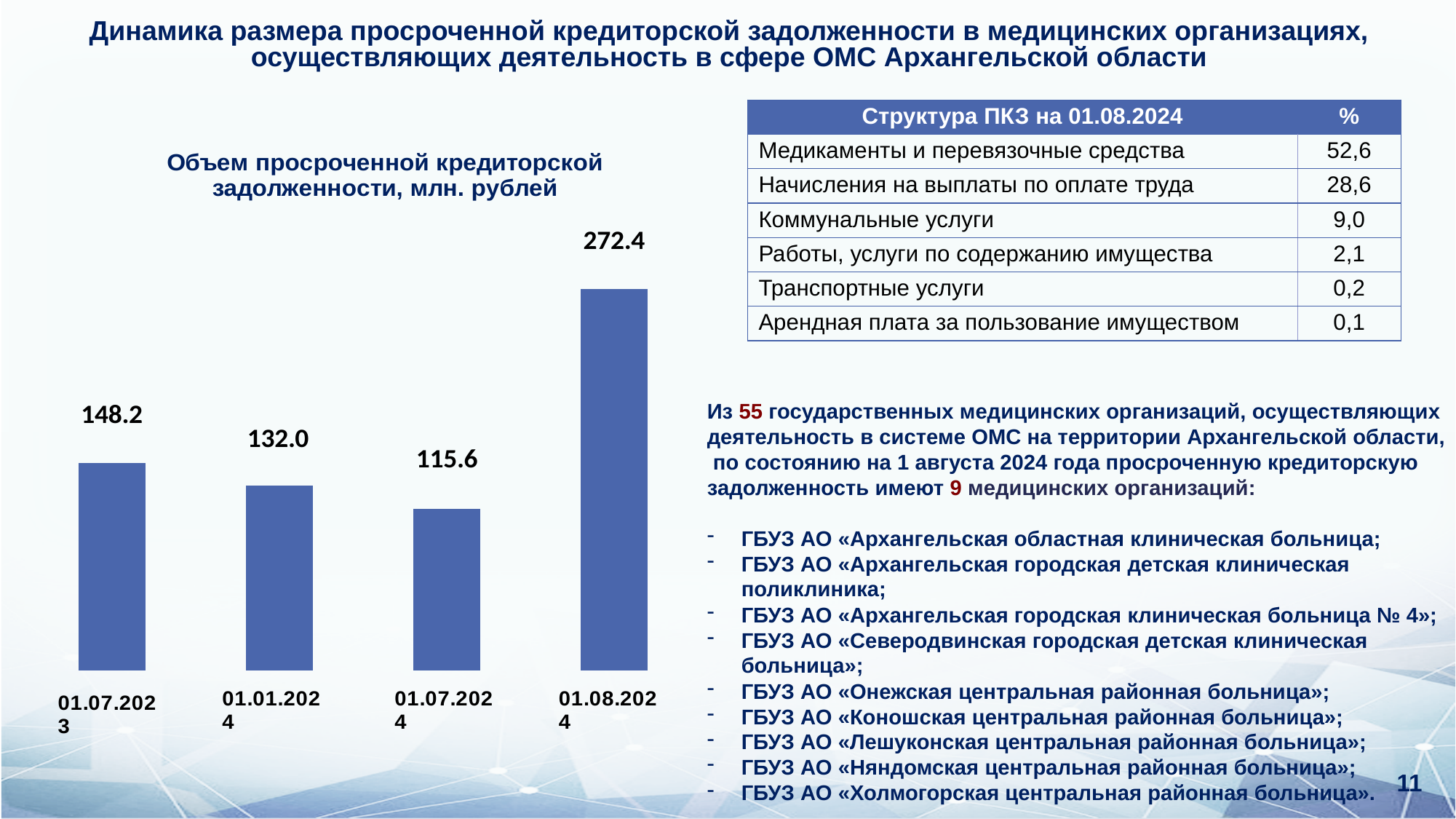
What is the value for 01.07.2023 in the chart? 148.2 What is the title of the chart? Объем просроченной кредиторской задолженности, млн. рублей Which date has the lowest value in the chart? 01.07.2024 What is the value for 01.08.2024 in the chart? 272.4 What kind of chart is shown on the slide? Bar chart What is the difference between the values for 01.07.2023 and 01.01.2024? 16.2 What is the value for 01.07.2024 in the chart? 115.6 Which is larger, the value for 01.07.2023 or the value for 01.01.2024? 01.07.2023 Which date has the highest value in the chart? 01.08.2024 How many dates are shown in the chart? 4 What is the value for 01.01.2024 in the chart? 132.0 What is the difference between the values for 01.08.2024 and 01.07.2024? 156.8